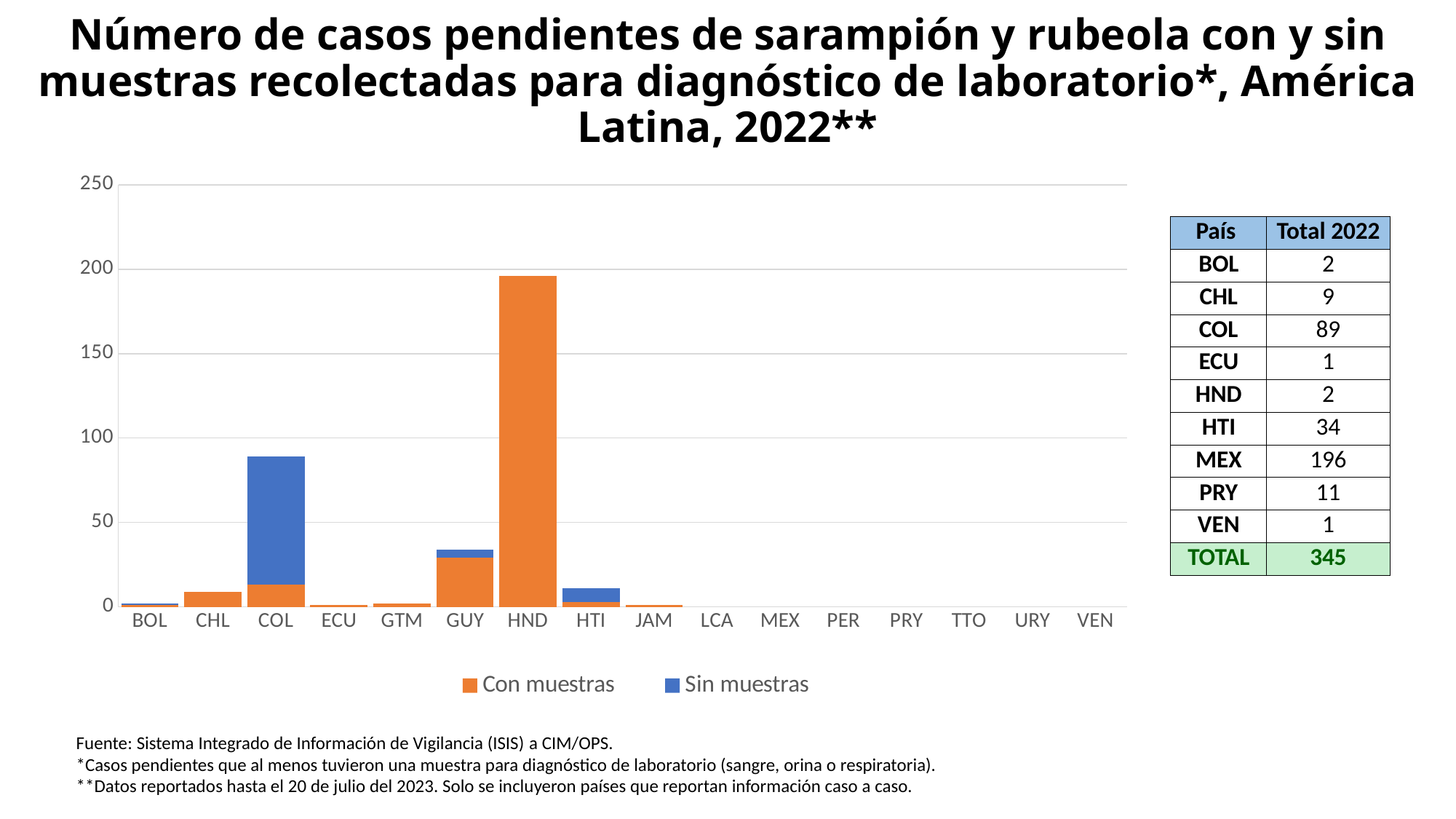
Which country has the largest 'Sin muestras' segment? COL Which bar is taller, COL or GUY? COL Is the total bar height for GUY greater or less than 50? less Which country has the tallest bar in the chart? HND Is the total bar height for COL greater or less than 50? greater How many series does the chart legend list? 2 What colour represents 'Sin muestras' in the chart? Blue What kind of chart is shown on the slide? Stacked bar chart Is the total bar height for HND greater or less than 150? greater How many countries are shown on the x axis of the chart? 16 What are the two series named in the chart legend? Con muestras, Sin muestras